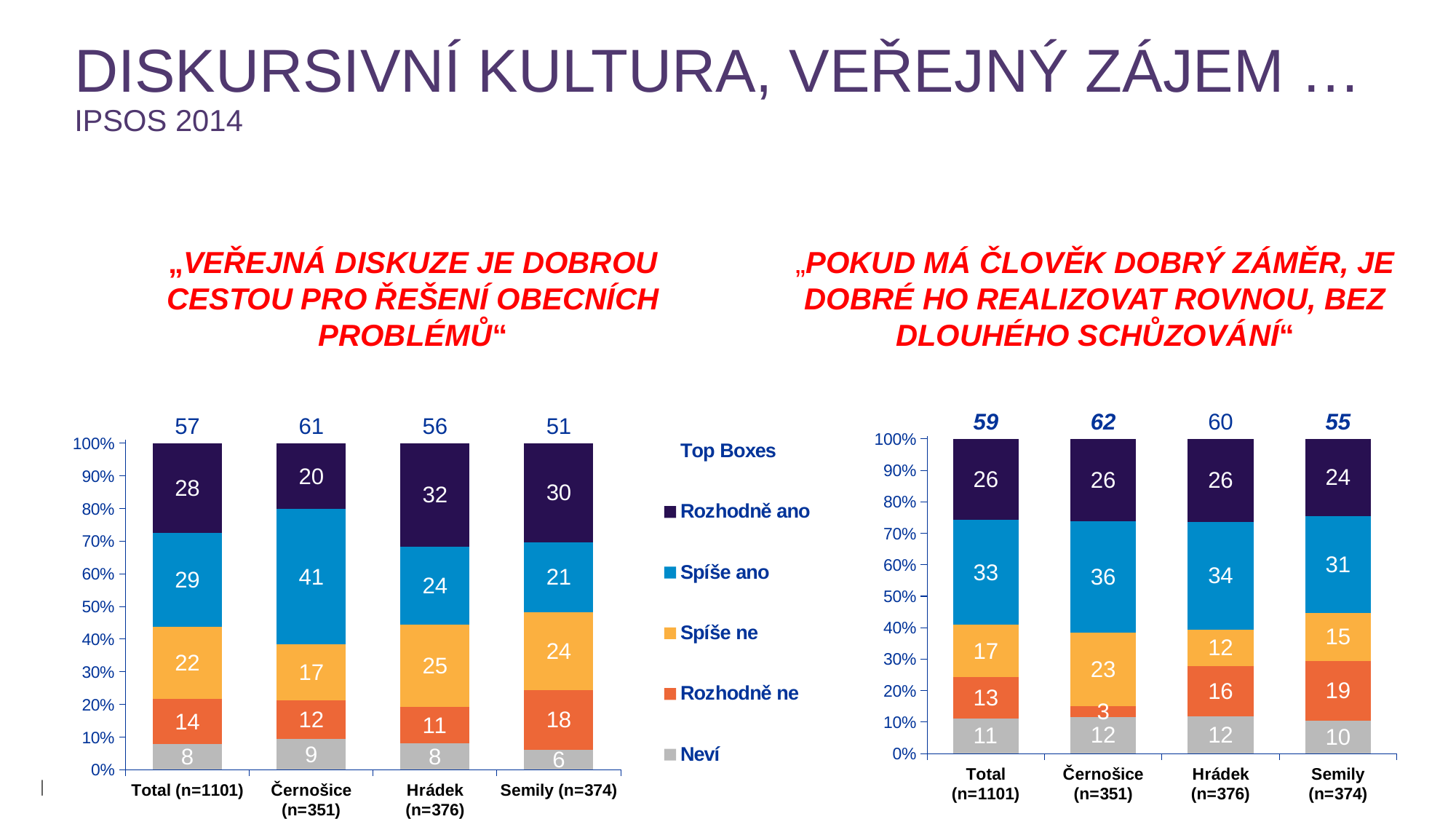
In the right chart ("Pokud má člověk dobrý záměr..."), which category has the lowest "Rozhodně ne" value? Černošice (n=351) In the left chart ("Veřejná diskuze je dobrou cestou pro řešení obecních problémů"), what is the difference between the "Spíše ano" values for Černošice (n=351) and Semily (n=374)? 20 In the right chart ("Pokud má člověk dobrý záměr..."), what is the value of "Spíše ne" for Černošice (n=351)? 23 What type of chart is the right chart ("Pokud má člověk dobrý záměr...")? Stacked bar chart In the left chart ("Veřejná diskuze je dobrou cestou pro řešení obecních problémů"), what is the value of "Rozhodně ne" for Semily (n=374)? 18 In the left chart ("Veřejná diskuze je dobrou cestou pro řešení obecních problémů"), which category has the highest "Rozhodně ano" value? Hrádek (n=376) How many categories are shown on the x axis of the left chart ("Veřejná diskuze je dobrou cestou pro řešení obecních problémů")? 4 In the left chart ("Veřejná diskuze je dobrou cestou pro řešení obecních problémů"), what is the total of the "Rozhodně ano" and "Spíše ano" values for Total (n=1101)? 57 In the right chart ("Pokud má člověk dobrý záměr..."), which is larger: the "Spíše ano" value for Černošice (n=351) or for Semily (n=374)? Černošice (n=351) In the left chart ("Veřejná diskuze je dobrou cestou pro řešení obecních problémů"), what is the value of "Spíše ano" for Černošice (n=351)? 41 In the right chart ("Pokud má člověk dobrý záměr..."), what is the Top Boxes value shown above the Semily (n=374) bar? 55